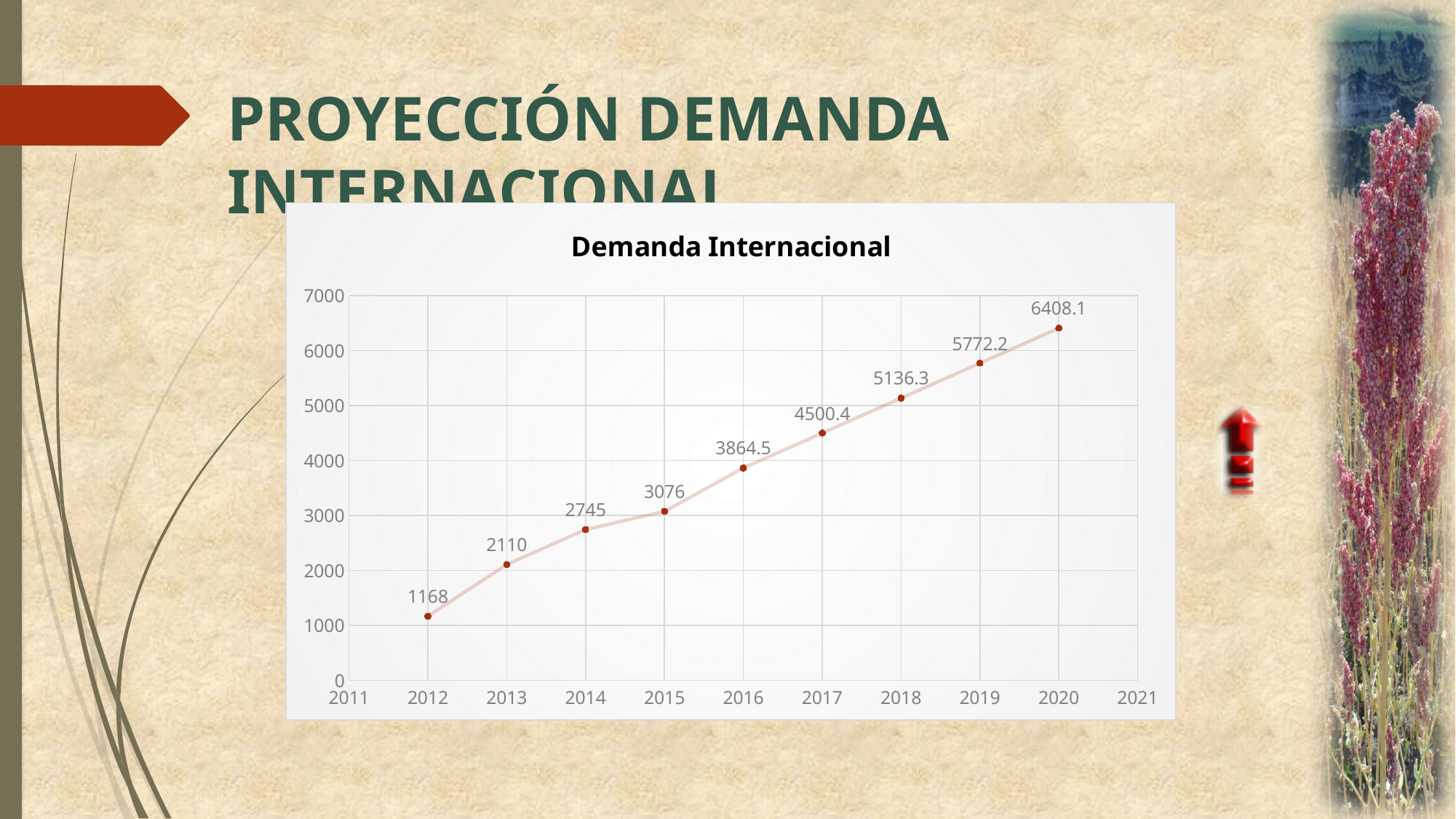
What is the difference between the values for 2013 and 2012? 942 What is the value for 2012? 1168 Which year has the lowest value? 2012 Which year has the highest value? 2020 Do the values rise or fall from 2012 to 2020? rise What is the difference between the values for 2020 and 2019? 635.9 What kind of chart is this? line chart How many data points are plotted? 9 What is the value for 2016? 3864.5 Is the value for 2018 greater or less than 5000? greater Which is larger, the value for 2015 or the value for 2017? 2017 What is the value for 2020? 6408.1